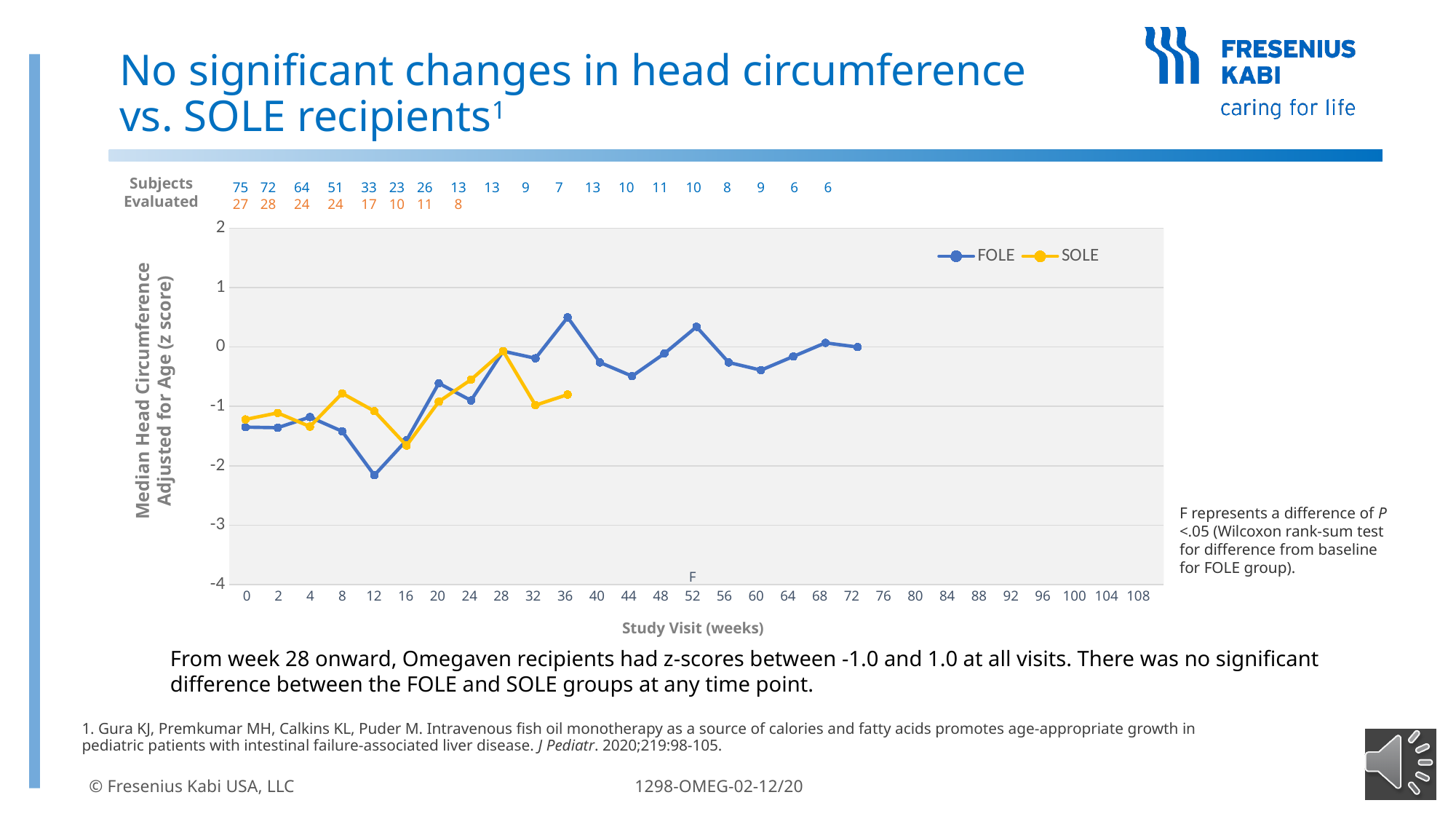
Is the FOLE value at week 12 greater or less than -2? less At which study visit week does the FOLE series reach its lowest value? 12 Is the FOLE value at week 36 greater or less than 0? greater At which study visit week does the SOLE series reach its lowest value? 16 At week 12, which series has the higher value, FOLE or SOLE? SOLE At which study visit week does the FOLE series reach its highest value? 36 What is the title of the x axis? Study Visit (weeks) Does the FOLE series rise or fall overall from week 12 to week 36? rise How many series does the legend list? 2 What type of chart is shown on the slide? Line chart What are the two series named in the legend? FOLE and SOLE At which study visit week does the SOLE series reach its highest value? 28